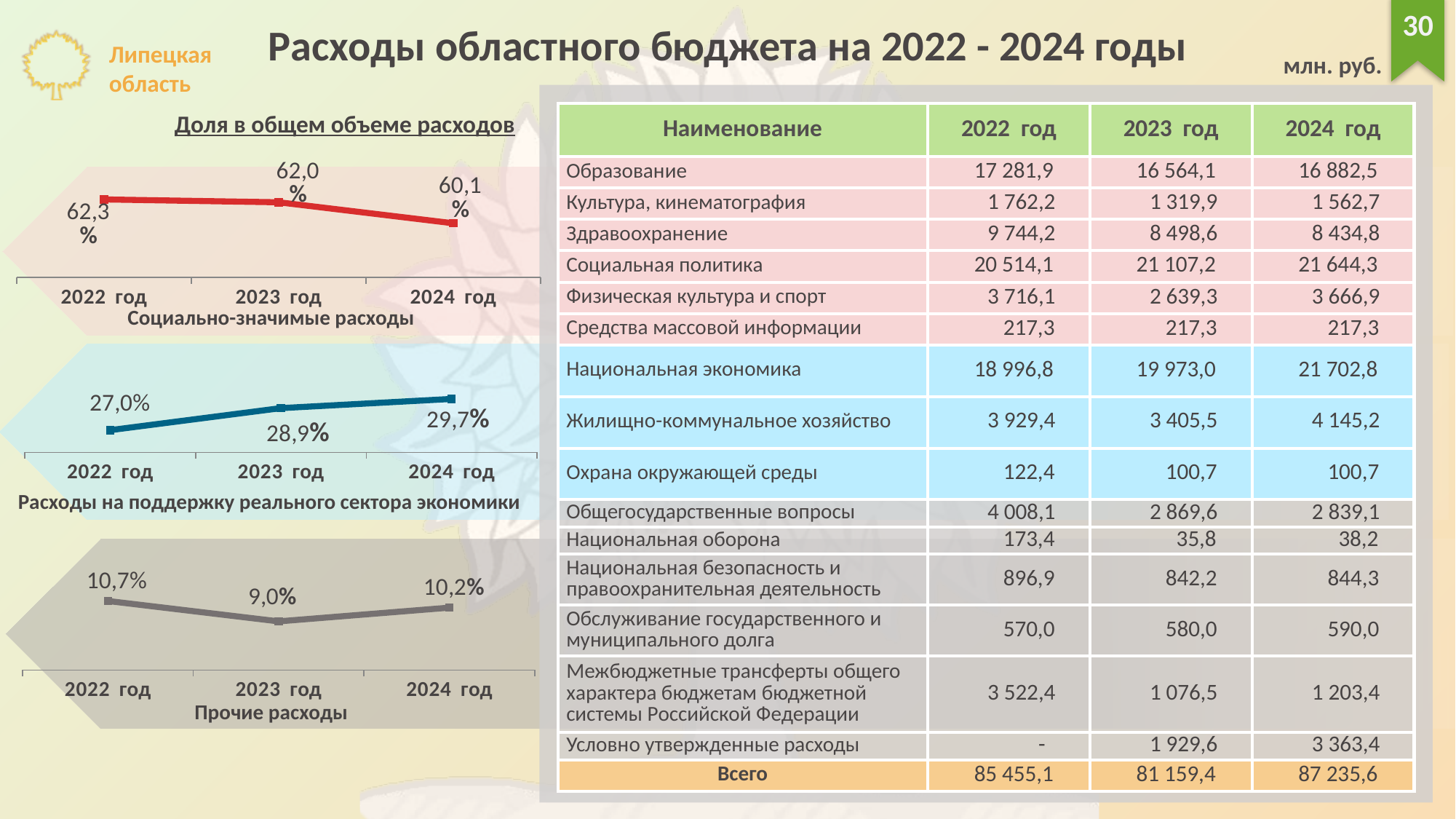
In the 'Социально-значимые расходы' chart, what is the value for 2022 год? 62,3% In the 'Социально-значимые расходы' chart, what is the value for 2024 год? 60,1% In the 'Социально-значимые расходы' chart, what is the difference between the 2022 год and 2024 год values? 2,2% In the 'Прочие расходы' chart, which is larger: the value for 2022 год or 2024 год? 2022 год What type of chart is used for 'Прочие расходы'? line chart How many data points are plotted in the 'Социально-значимые расходы' chart? 3 In the 'Прочие расходы' chart, which year has the highest value? 2022 год In the 'Расходы на поддержку реального сектора экономики' chart, do the values rise or fall from 2022 год to 2024 год? rise In the 'Расходы на поддержку реального сектора экономики' chart, what is the value for 2023 год? 28,9% In the 'Прочие расходы' chart, what is the value for 2023 год? 9,0% In the 'Расходы на поддержку реального сектора экономики' chart, what is the difference between the 2024 год and 2022 год values? 2,7% In the 'Расходы на поддержку реального сектора экономики' chart, which year has the lowest value? 2022 год